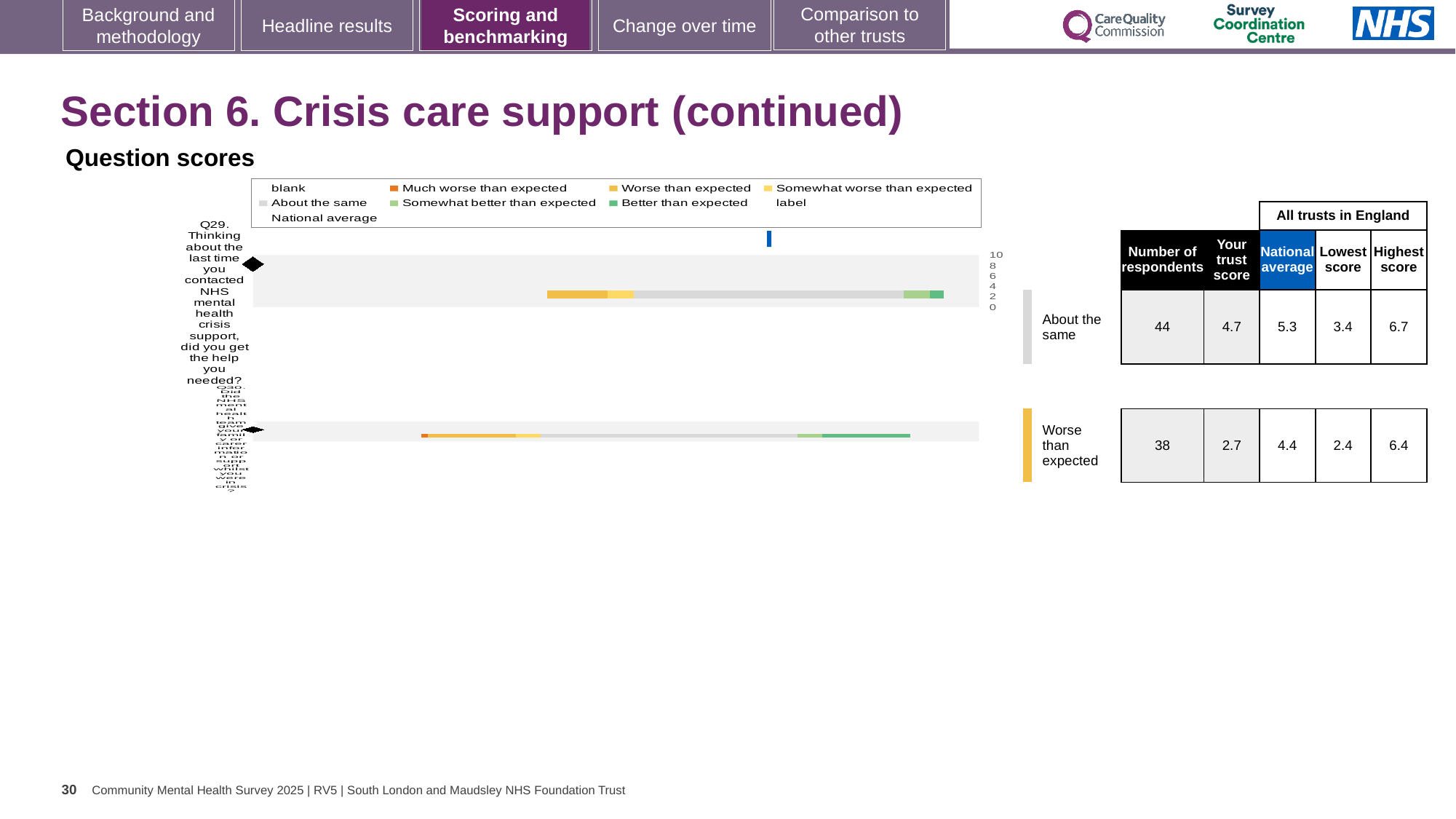
What kind of chart is used to show the question scores on this slide? bar chart According to the table beside the chart, what is the national average for Q29? 5.3 Which benchmark category is shown for Q30 in the question scores chart? Worse than expected What is the maximum value shown on the score axis of the question scores chart? 10 Which benchmark category is shown for Q29 in the question scores chart? About the same Which question has the higher trust score, Q29 or Q30? Q29 According to the table beside the chart, how many respondents answered Q30? 38 According to the table beside the chart, what is the trust score for Q29? 4.7 What is the difference between the national average and the trust score for Q30? 1.7 How many entries does the legend of the question scores chart list? 9 How many questions (bars) are plotted in the question scores chart? 2 According to the table beside the chart, what is the trust score for Q30? 2.7